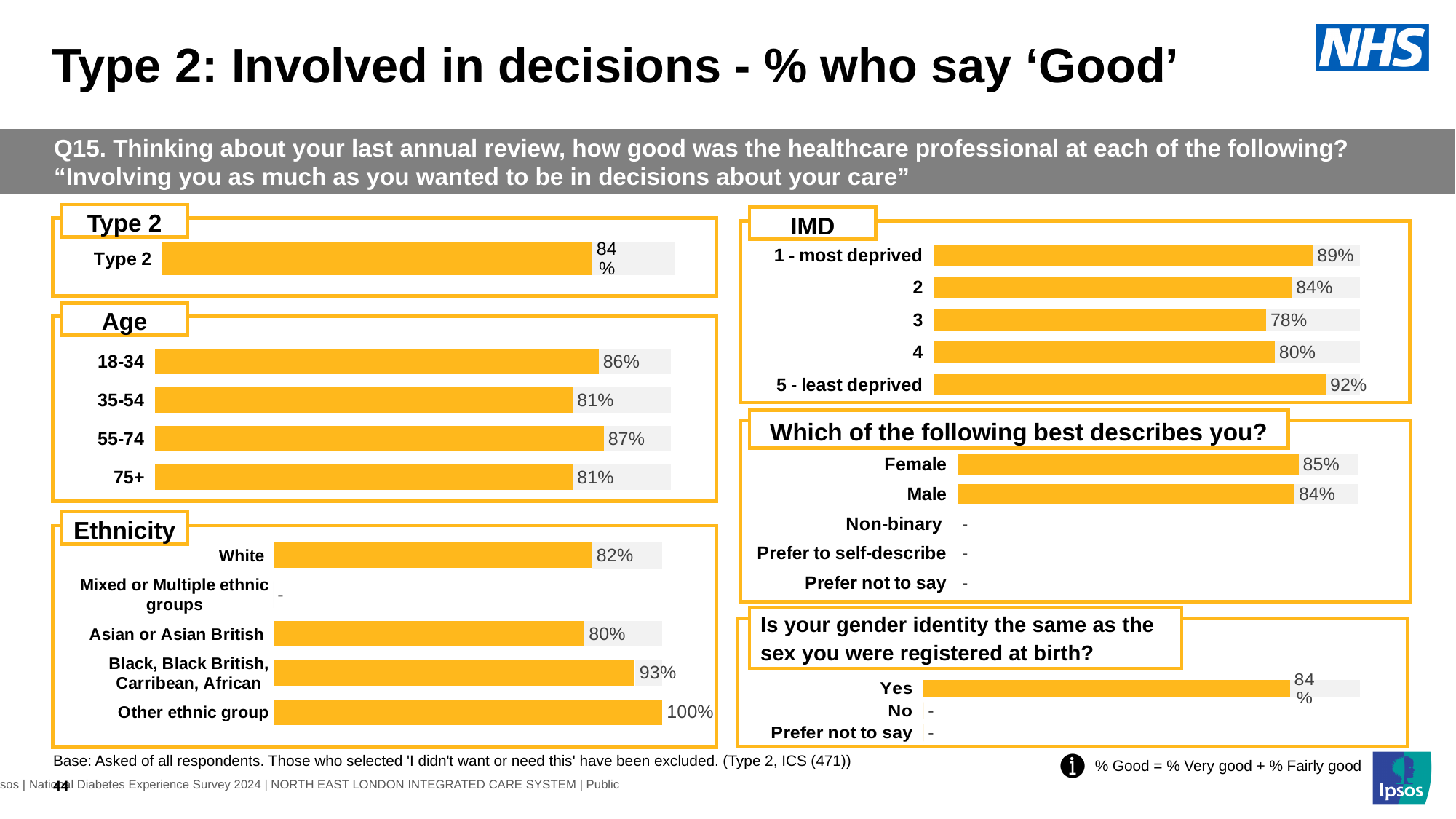
In the Ethnicity chart, which category has the highest value? Other ethnic group In the Ethnicity chart, what is the value for Black, Black British, Carribean, African? 93% In the IMD chart, which category has the lowest value? 3 How many categories are listed in the IMD chart? 5 In the Age chart, which age group has the highest value? 55-74 In the IMD chart, which category has the highest value? 5 - least deprived In the IMD chart, what is the value for 3? 78% In the Ethnicity chart, which is larger, White or Asian or Asian British? White In the Age chart, what is the value for 18-34? 86% In the IMD chart, what is the difference between 5 - least deprived and 1 - most deprived? 3 percentage points In the 'Which of the following best describes you?' chart, what is the value for Female? 85% What kind of chart is the Age chart? Bar chart